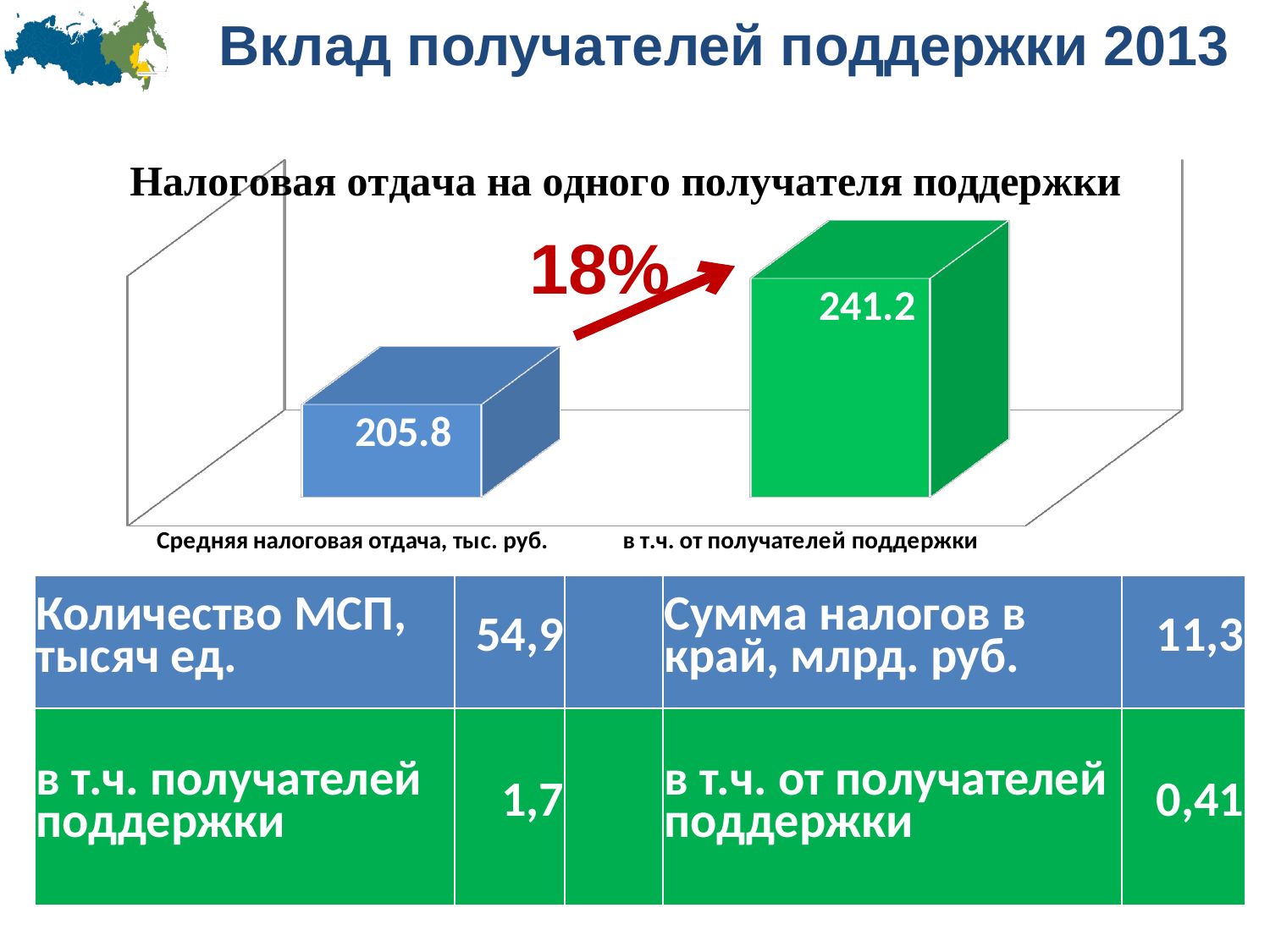
What is the value of the bar labelled "Средняя налоговая отдача, тыс. руб."? 205.8 What kind of chart is shown on the slide? bar chart Which category has the highest value in the chart? в т.ч. от получателей поддержки What is the difference between the values for "в т.ч. от получателей поддержки" and "Средняя налоговая отдача, тыс. руб."? 35.4 What is the value of the bar labelled "в т.ч. от получателей поддержки"? 241.2 Which category has the lowest value in the chart? Средняя налоговая отдача, тыс. руб. What is the title of the chart? Налоговая отдача на одного получателя поддержки How many bars are plotted in the chart? 2 Which is larger: the value for "Средняя налоговая отдача, тыс. руб." or the value for "в т.ч. от получателей поддержки"? в т.ч. от получателей поддержки Do the values rise or fall from left to right across the chart? rise What percentage is written next to the red arrow between the two bars? 18%